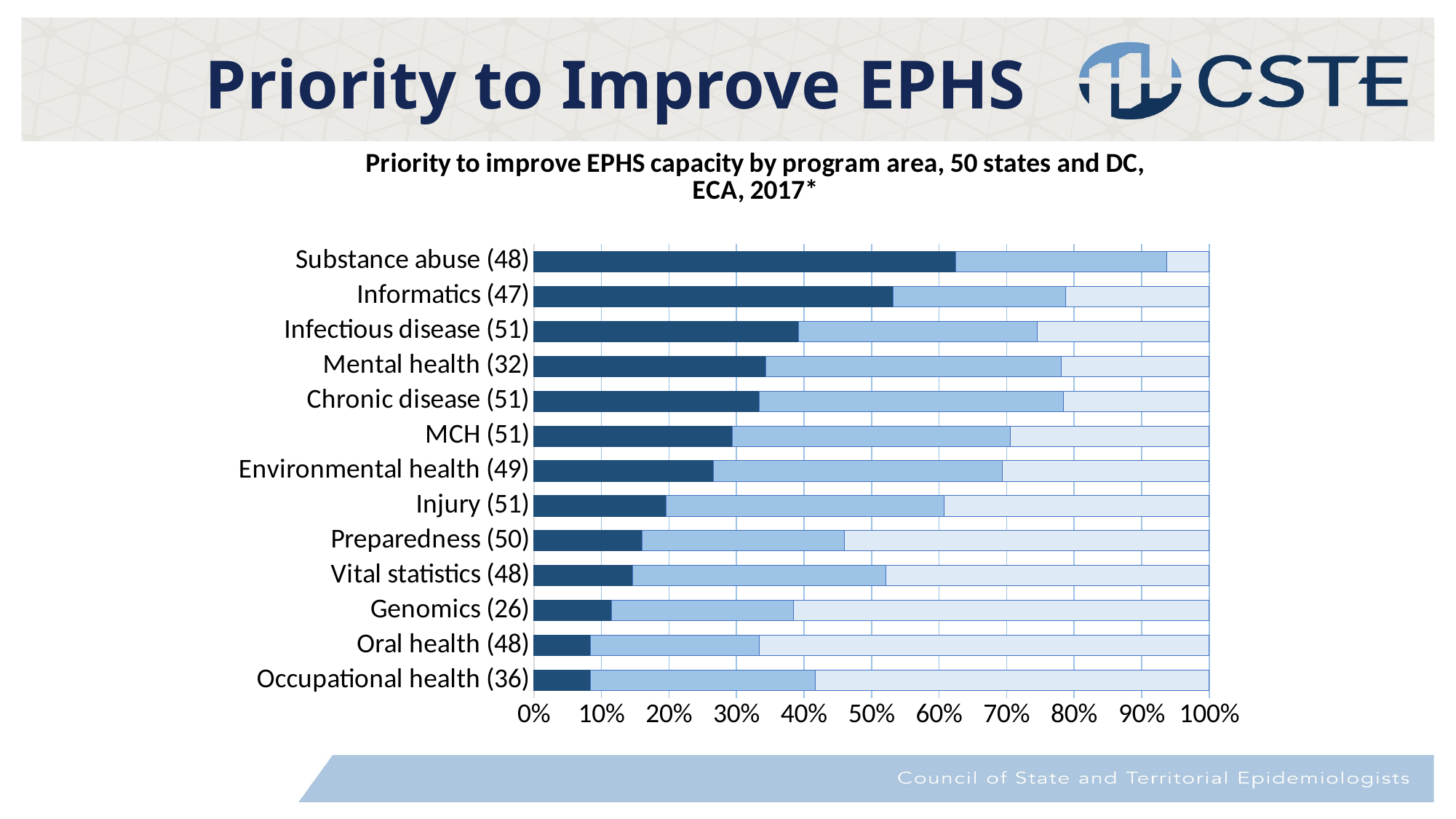
What kind of chart is shown on the slide? Stacked bar chart Is the dark blue segment for Genomics (26) greater or less than 20%? less Is the dark blue segment for Informatics (47) greater or less than 40%? greater Is the dark blue segment for Environmental health (49) greater or less than 30%? less What number appears in parentheses next to Mental health? 32 Which has a longer dark blue segment, Substance abuse (48) or Informatics (47)? Substance abuse (48) Which has a longer dark blue segment, Injury (51) or Infectious disease (51)? Infectious disease (51) Which program area has the longest dark blue segment? Substance abuse (48) How many program areas are listed on the chart? 13 What is the title of the chart? Priority to improve EPHS capacity by program area, 50 states and DC, ECA, 2017*